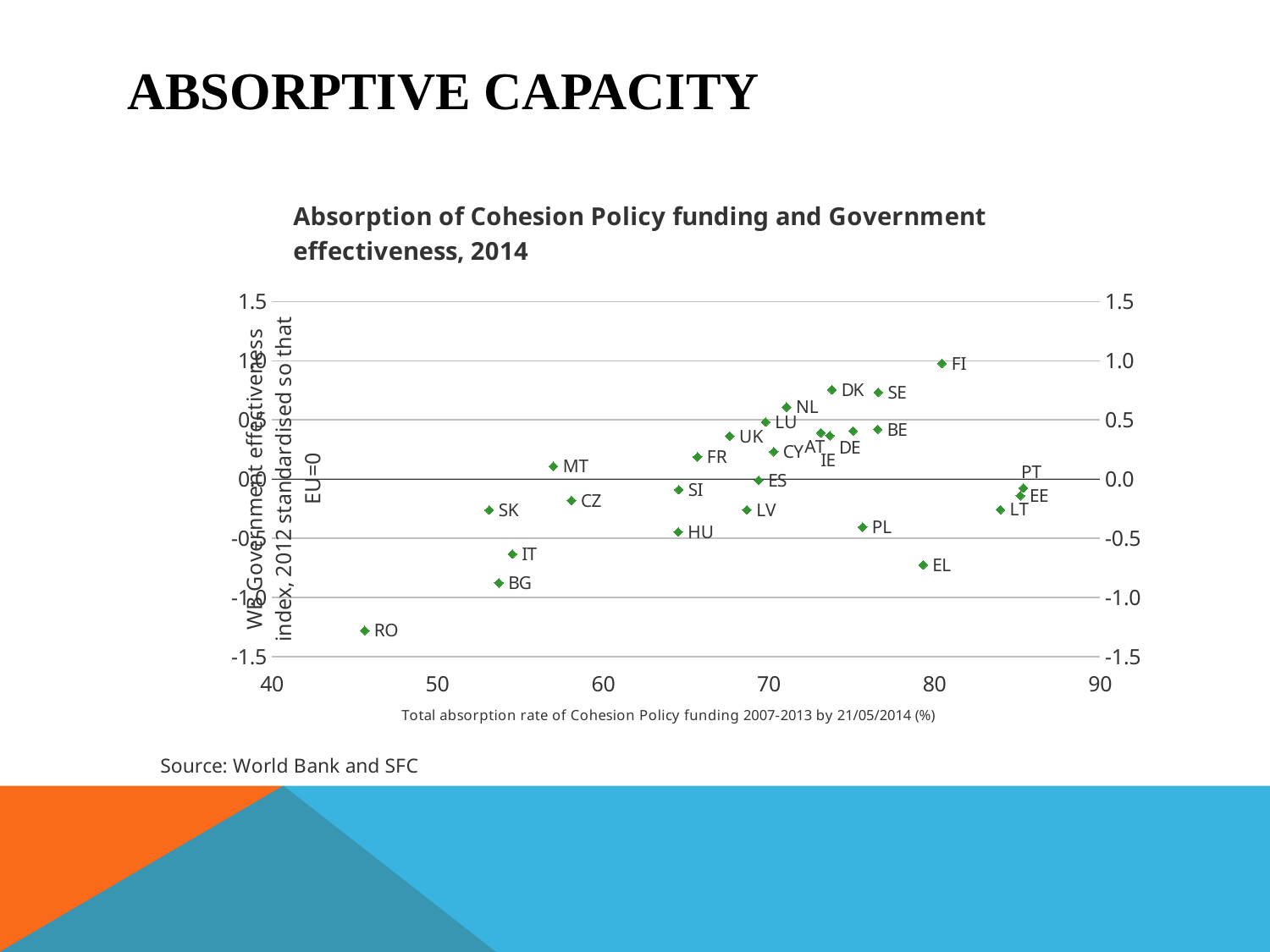
How many country points are plotted on the chart? 27 Which has the higher government effectiveness value, DK or EL? DK Is the total absorption rate for RO greater or less than 50? less Is the government effectiveness value for FI greater or less than 0.5? greater Which country has the lowest total absorption rate? RO Which country has the highest government effectiveness value? FI Which country has the lowest government effectiveness value? RO Is the total absorption rate for PL greater or less than 70? greater What is the title of the chart? Absorption of Cohesion Policy funding and Government effectiveness, 2014 What is the label of the horizontal axis? Total absorption rate of Cohesion Policy funding 2007-2013 by 21/05/2014 (%) What kind of chart is shown on the slide? Scatter chart